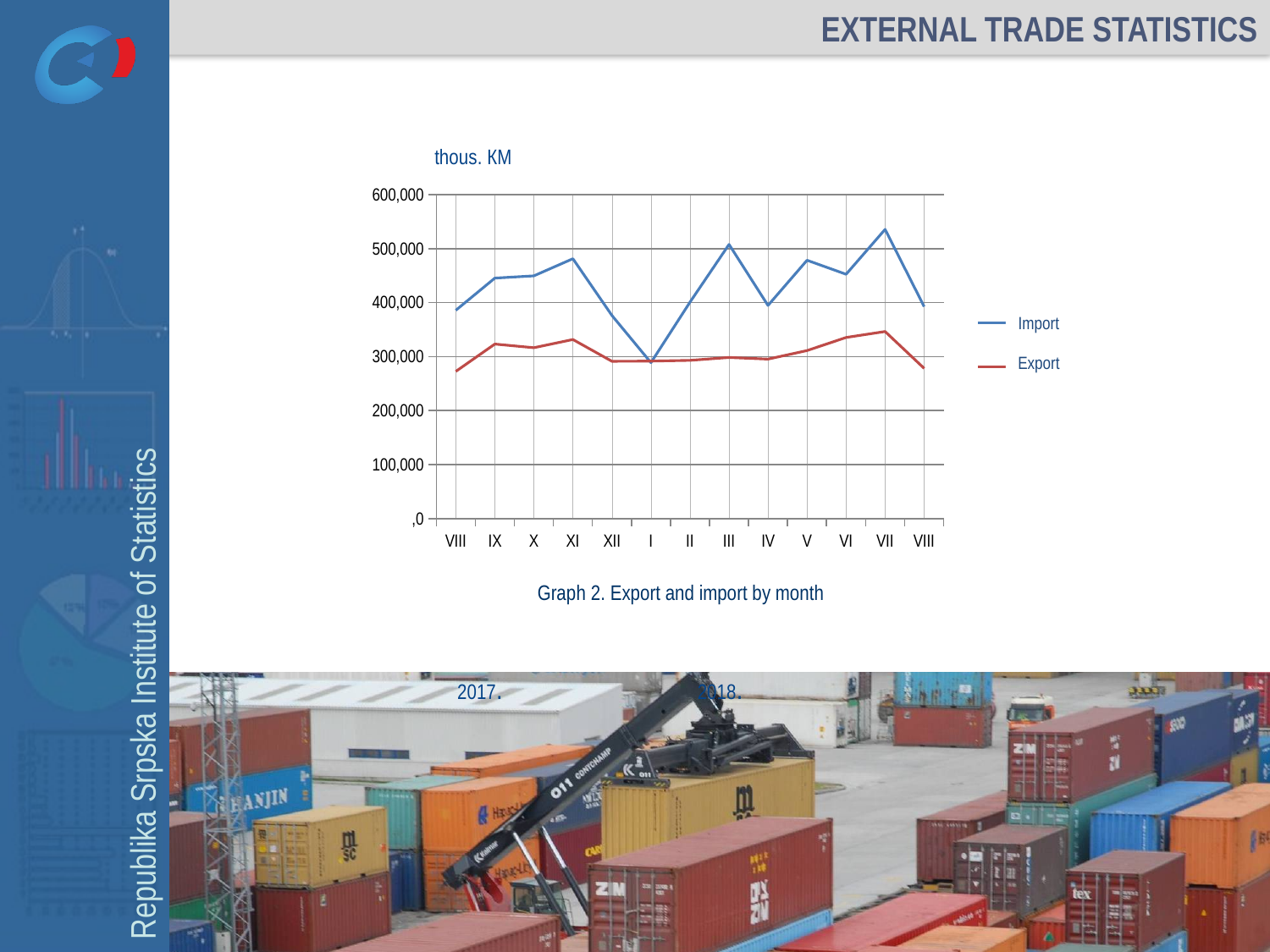
How many months are plotted along the x axis? 13 In which month does the Import line reach its lowest value? I Is the Import value for month XI greater or less than 400,000? greater Is the Import value for month VII greater or less than 500,000? greater What is the caption of the graph? Graph 2. Export and import by month How many series does the legend list? 2 In which month does the Import line reach its highest value? VII Is the Import value for month I greater or less than 400,000? less What kind of chart is shown on the slide? line chart Does the Import line rise or fall from month XI to month I? fall Which is larger in month VII, Import or Export? Import